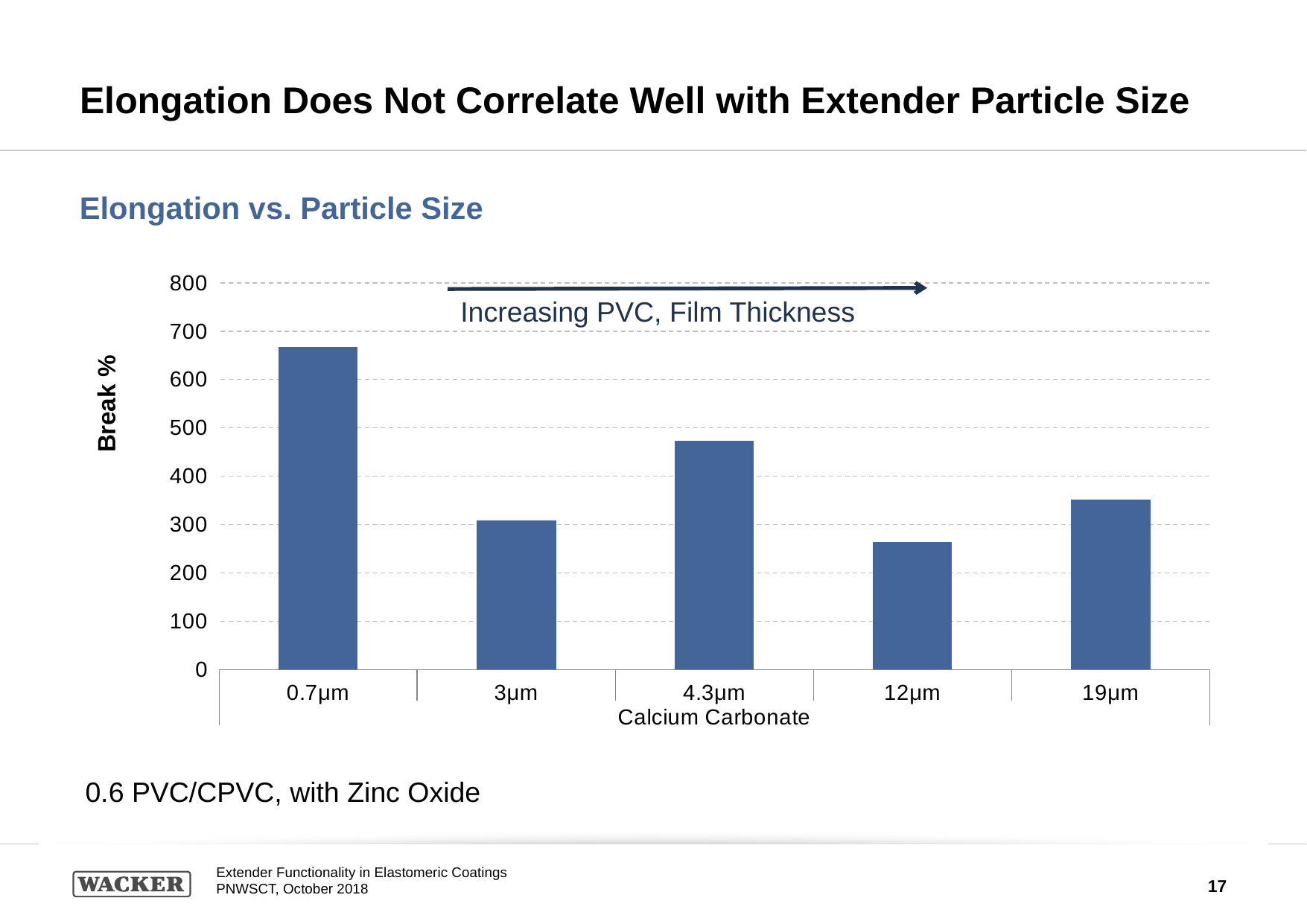
Which has a higher Break %, 3µm or 4.3µm? 4.3µm Which particle size has the lowest Break %? 12µm How many particle size categories are plotted on the chart? 5 Is the Break % for 19µm greater or less than 400? less Which particle size has the highest Break %? 0.7µm What is the title of the chart? Elongation vs. Particle Size What kind of chart is shown on the slide? bar chart Is the Break % for 4.3µm greater or less than 500? less Is the Break % for 12µm greater or less than 300? less What is the label on the vertical axis of the chart? Break % Which has a higher Break %, 12µm or 19µm? 19µm